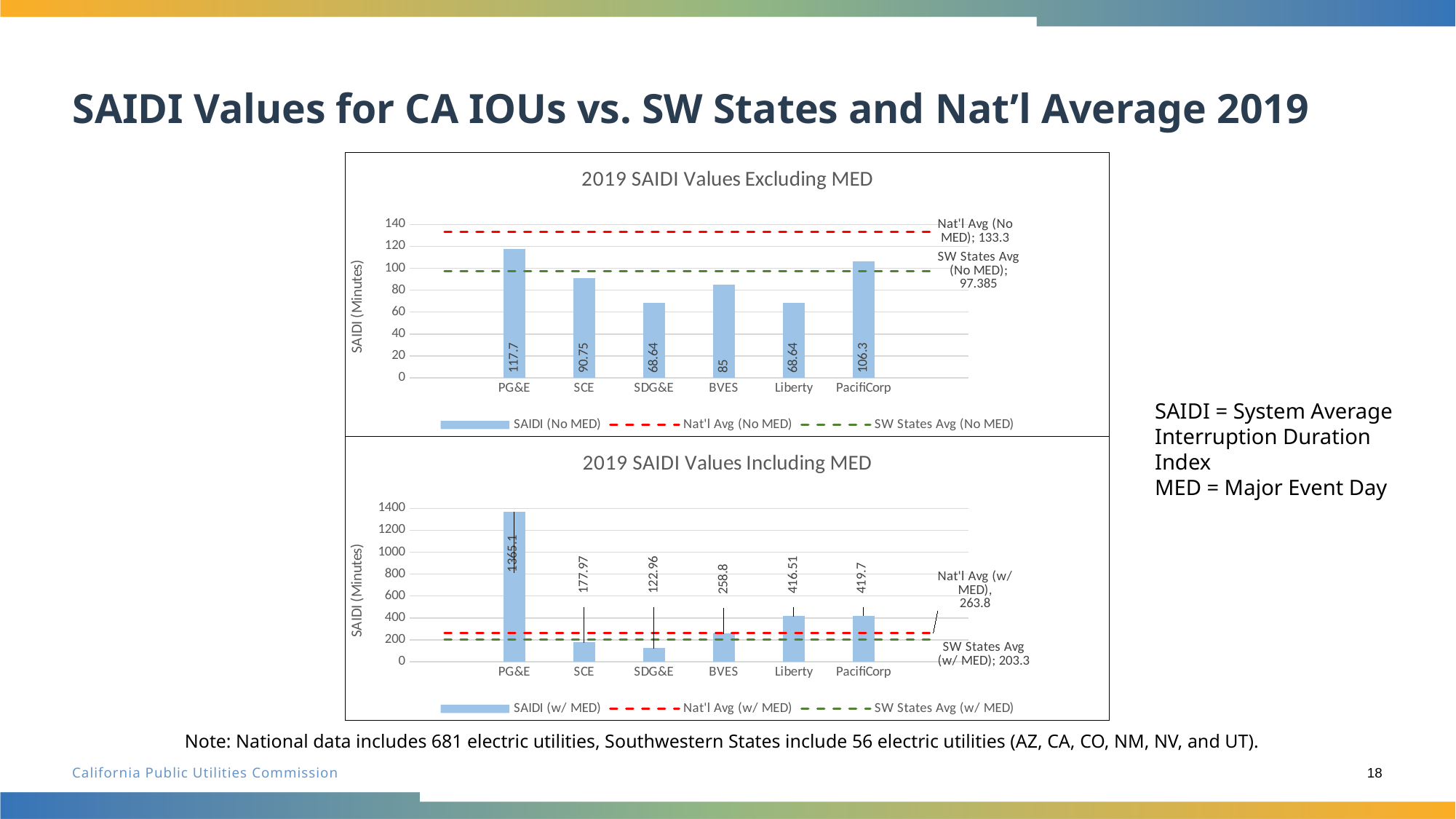
In the '2019 SAIDI Values Excluding MED' chart, how many series does the legend list? 3 In the '2019 SAIDI Values Excluding MED' chart, what is the SAIDI value for PG&E? 117.7 In the '2019 SAIDI Values Excluding MED' chart, which utility has the highest SAIDI value? PG&E How many utilities are shown on the x axis of the '2019 SAIDI Values Including MED' chart? 6 In the '2019 SAIDI Values Including MED' chart, which is larger, the value for Liberty or the value for BVES? Liberty In the '2019 SAIDI Values Excluding MED' chart, what is the SAIDI value for SCE? 90.75 In the '2019 SAIDI Values Including MED' chart, what is the SW States Avg (w/ MED) value shown? 203.3 In the '2019 SAIDI Values Excluding MED' chart, what is the Nat'l Avg (No MED) value shown? 133.3 In the '2019 SAIDI Values Including MED' chart, what is the SAIDI value for PG&E? 1365.1 What kind of chart is the '2019 SAIDI Values Excluding MED' chart? Bar chart In the '2019 SAIDI Values Excluding MED' chart, what is the difference between the PG&E value and the PacifiCorp value? 11.4 In the '2019 SAIDI Values Including MED' chart, which utility has the lowest SAIDI value? SDG&E